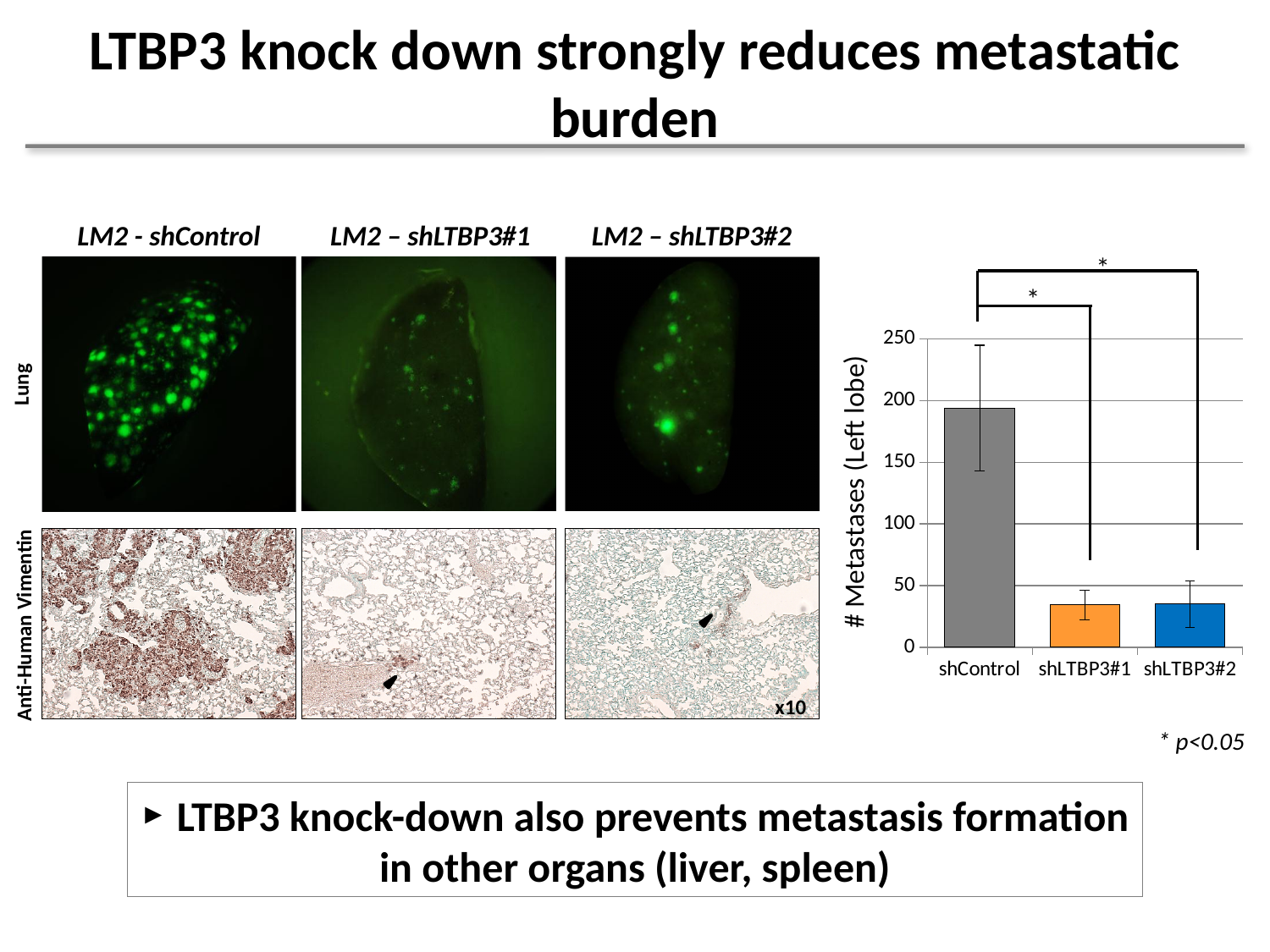
Is the value for shControl greater or less than 150? greater What kind of chart is shown on the right of the slide? bar chart What is the label of the y axis on the bar chart? # Metastases (Left lobe) Which is larger, the value for shLTBP3#2 or the value for shControl? shControl Is the value for shControl greater or less than 200? less Is the value for shLTBP3#1 greater or less than 50? less Which category has the highest number of metastases in the bar chart? shControl What colour is the shLTBP3#1 bar in the chart? orange Which is larger, the value for shControl or the value for shLTBP3#1? shControl What is the highest tick value shown on the y axis of the bar chart? 250 How many categories are plotted on the bar chart? 3